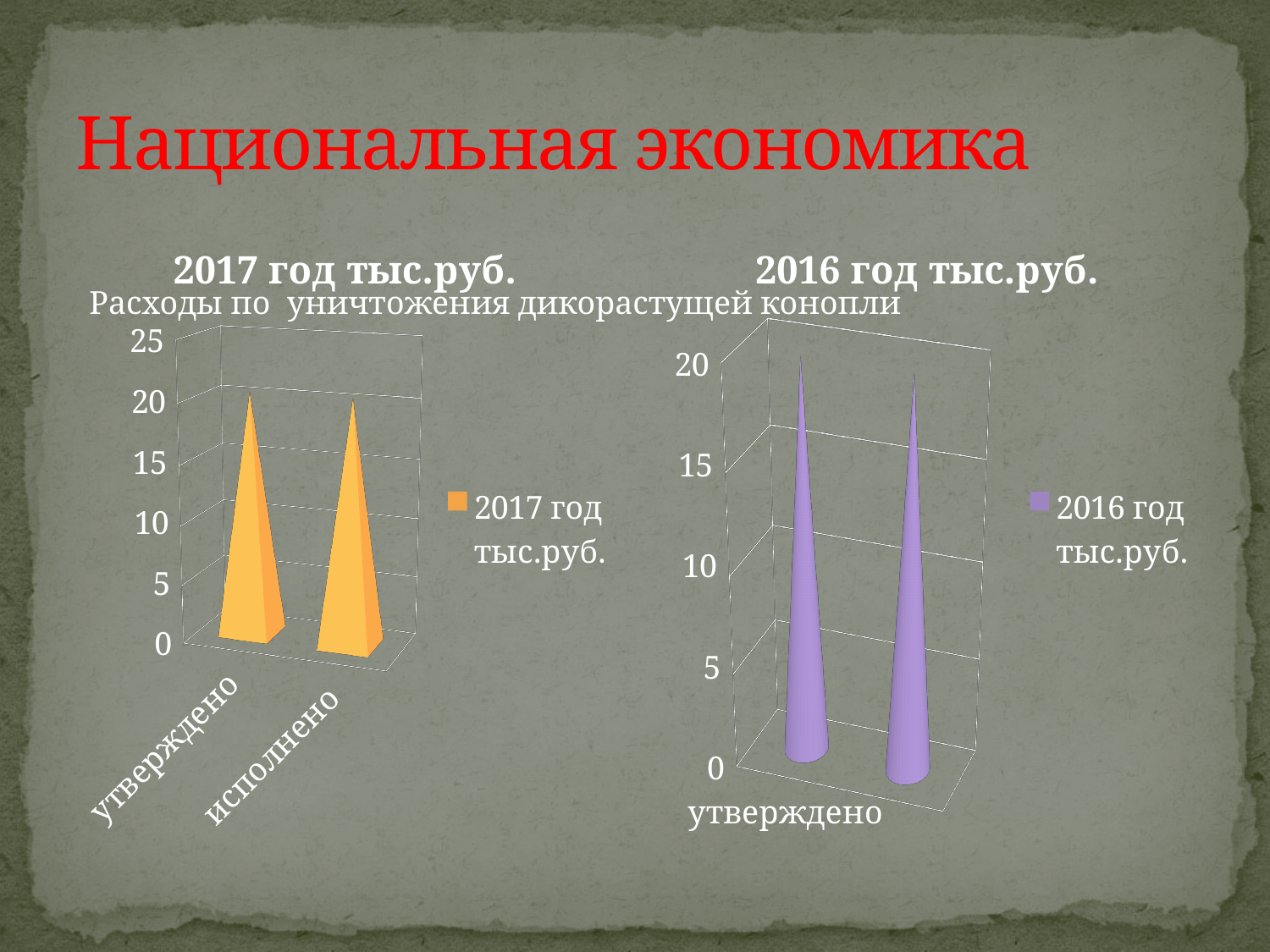
How many series does the legend of the right chart (2016 год тыс.руб.) list? 1 In the right chart (2016 год тыс.руб.), is the value for "утверждено" greater or less than 15? greater How many series does the legend of the left chart (2017 год тыс.руб.) list? 1 What colour are the bars in the left chart (2017 год тыс.руб.)? orange In the left chart (2017 год тыс.руб.), is the value for "исполнено" greater or less than 25? less In the right chart (2016 год тыс.руб.), is the value for "утверждено" greater or less than 10? greater What kind of chart is the left chart titled "2017 год тыс.руб."? bar chart How many categories are shown on the x axis of the left chart (2017 год тыс.руб.)? 2 What is the legend entry of the right chart (2016 год тыс.руб.)? 2016 год тыс.руб.